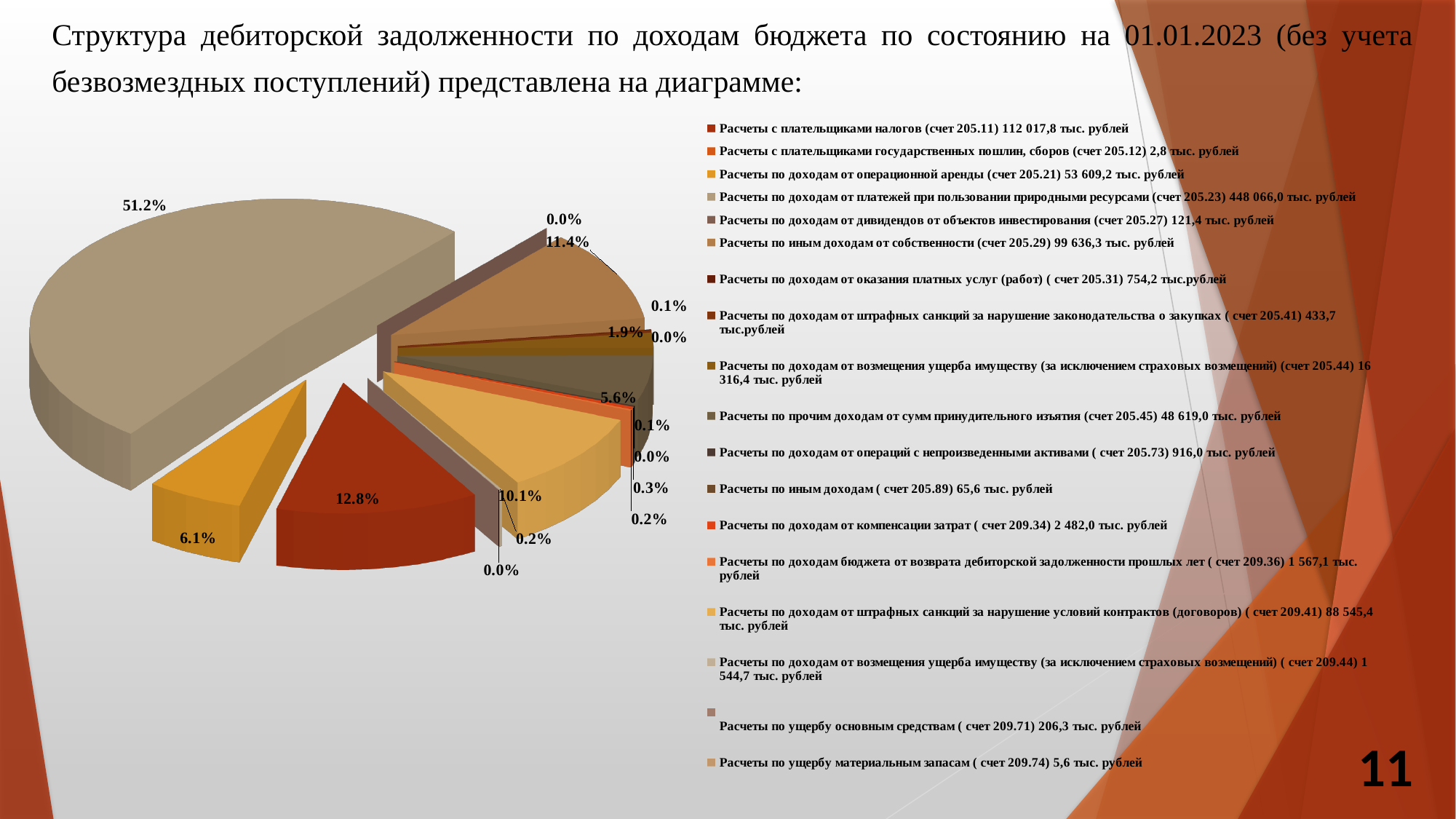
As of what date does the slide title say the structure of receivables is presented? 01.01.2023 How many categories does the legend of the pie chart list? 18 Which is larger on the pie chart: the slice labelled 12.8% or the slice labelled 6.1%? 12.8% What is the difference in percentage points between the 51.2% slice and the 12.8% slice? 38.4 What amount is listed in the legend for Расчеты по иным доходам от собственности (счет 205.29)? 99 636,3 тыс. рублей What is the largest share shown on the pie chart? 51.2% What amount is listed in the legend for Расчеты с плательщиками налогов (счет 205.11)? 112 017,8 тыс. рублей Which legend entry has the larger amount: счет 205.45 (48 619,0 тыс. рублей) or счет 209.41 (88 545,4 тыс. рублей)? счет 209.41 Which category has the largest share of the pie chart? Расчеты по доходам от платежей при пользовании природными ресурсами (счет 205.23) What kind of chart is shown on the slide? Pie chart What amount is listed in the legend for Расчеты по ущербу материальным запасам (счет 209.74)? 5,6 тыс. рублей What amount is listed in the legend for Расчеты по доходам от операционной аренды (счет 205.21)? 53 609,2 тыс. рублей